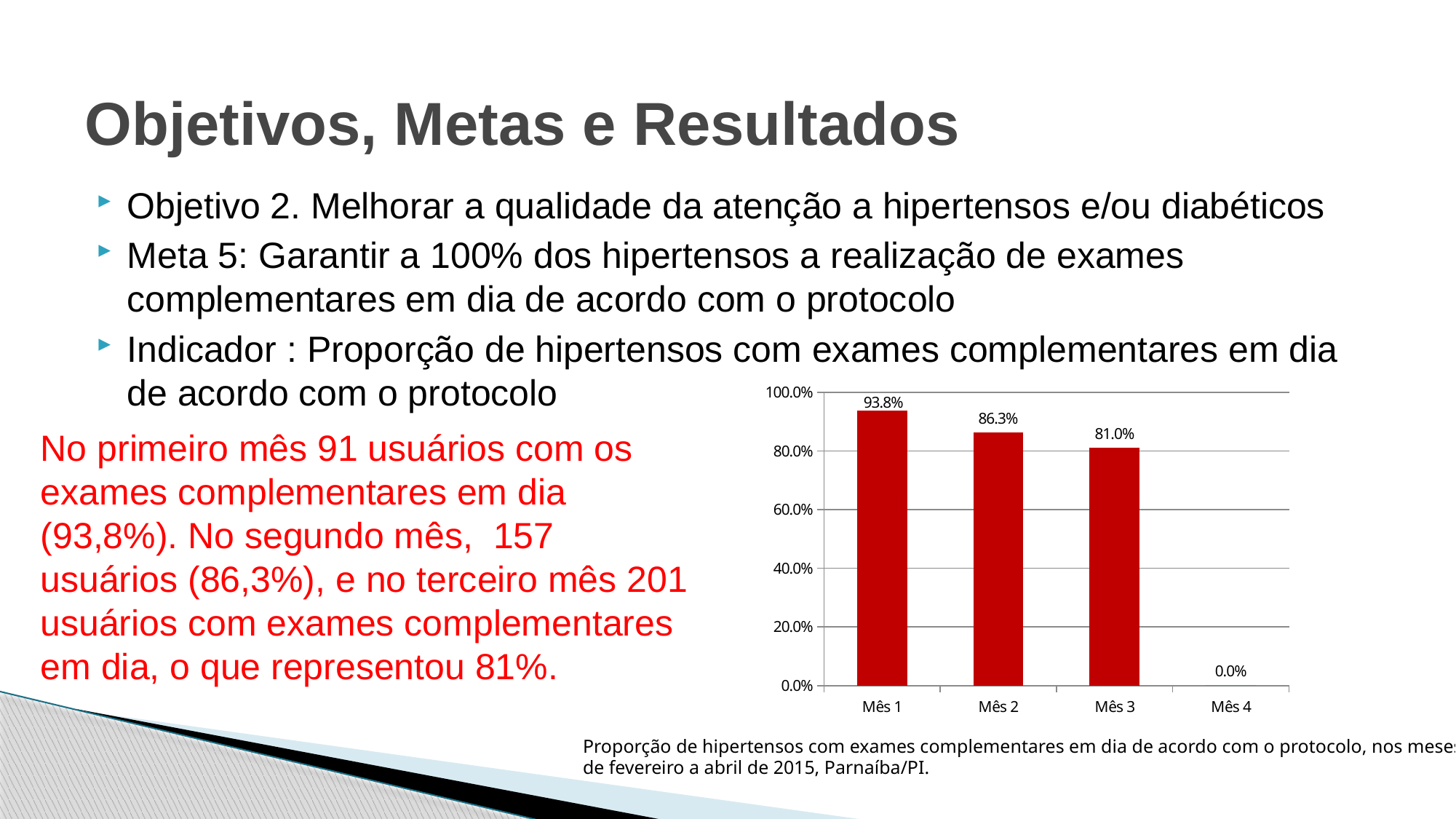
What is the value for Mês 3? 81.0% Which month has the highest value? Mês 1 What kind of chart is shown on the slide? bar chart What is the value for Mês 4? 0.0% Is the value for Mês 2 greater or less than 80.0%? greater What is the difference between the values for Mês 1 and Mês 3? 12.8% How many months are shown on the x axis? 4 What is the value for Mês 1? 93.8% Do the values rise or fall from Mês 1 to Mês 3? fall Which is larger, the value for Mês 2 or the value for Mês 3? Mês 2 Which month has the lowest value? Mês 4 What is the value for Mês 2? 86.3%